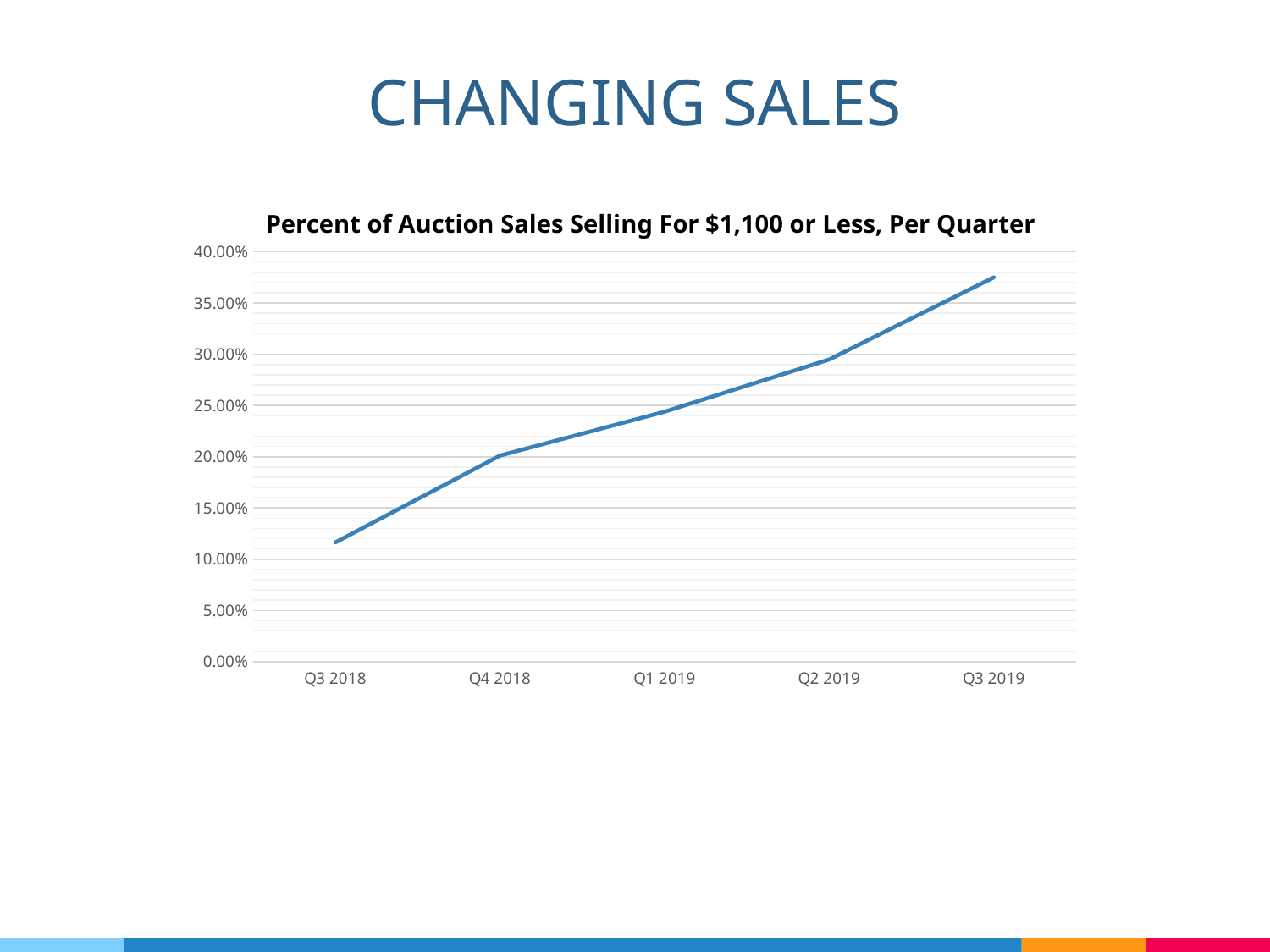
What kind of chart is shown on the slide? line chart Which is larger, the value for Q4 2018 or the value for Q2 2019? Q2 2019 Is the value for Q4 2018 greater or less than 25.00%? less Which quarter has the highest value? Q3 2019 Is the value for Q3 2019 greater or less than 35.00%? greater What is the title of the chart? Percent of Auction Sales Selling For $1,100 or Less, Per Quarter Do the values rise or fall from Q3 2018 to Q3 2019? rise Which quarter has the lowest value? Q3 2018 Is the value for Q2 2019 greater or less than 25.00%? greater How many quarters are plotted on the x axis? 5